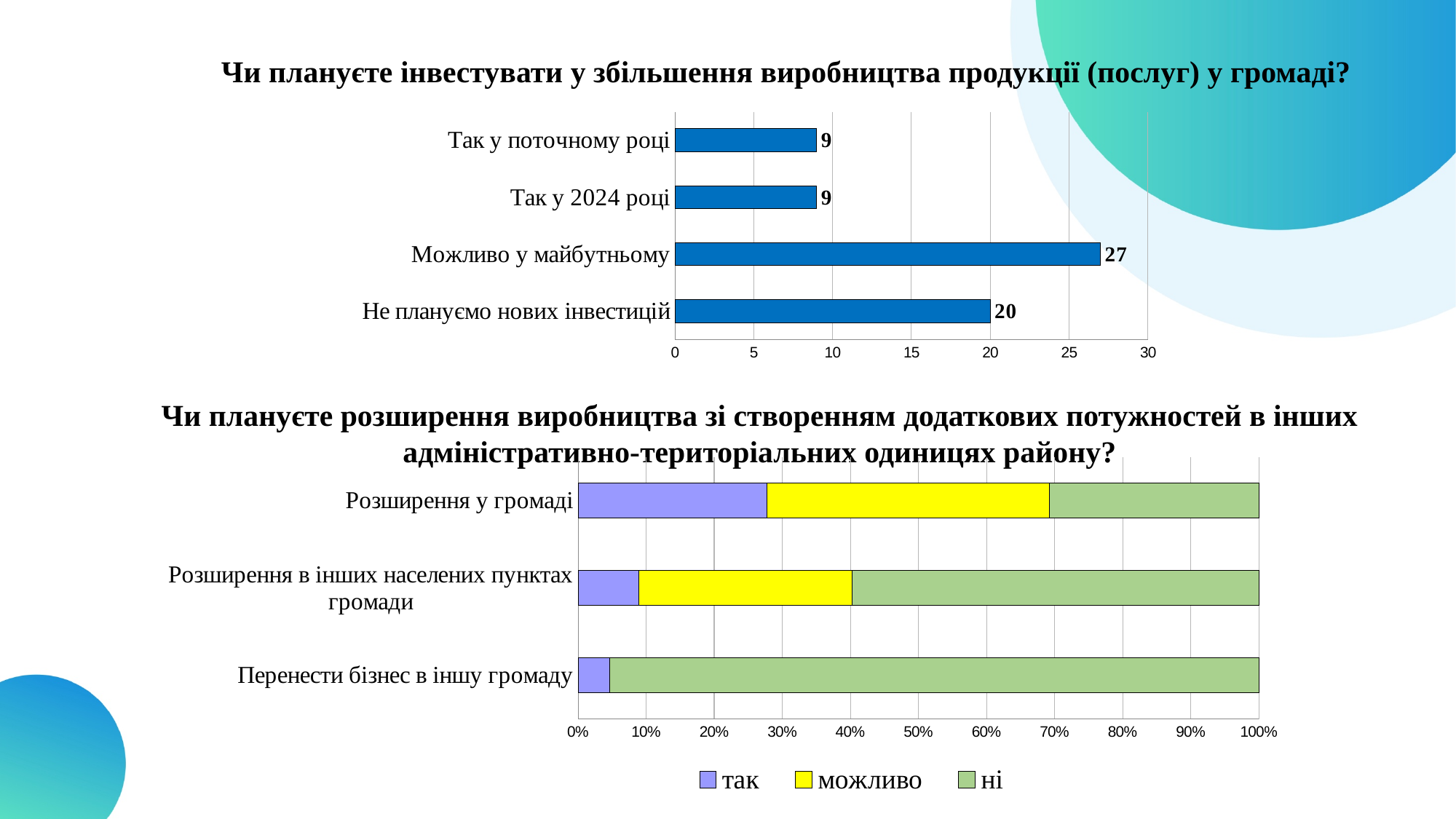
In the bottom chart, is the "так" share for "Розширення у громаді" greater or less than 20%? greater In the top chart, what is the difference between "Можливо у майбутньому" and "Не плануємо нових інвестицій"? 7 In the bottom chart, which colour represents the series "можливо"? Yellow In the top chart, which is larger: "Не плануємо нових інвестицій" or "Так у поточному році"? Не плануємо нових інвестицій What kind of chart is the top chart? Bar chart In the top chart ("Чи плануєте інвестувати у збільшення виробництва продукції (послуг) у громаді?"), what is the value for "Можливо у майбутньому"? 27 How many series does the legend of the bottom chart list? 3 In the bottom chart, is the "ні" share for "Перенести бізнес в іншу громаду" greater or less than 90%? greater How many categories does the top chart show? 4 In the top chart, which category has the highest value? Можливо у майбутньому In the top chart, what is the value for "Не плануємо нових інвестицій"? 20 In the top chart, what is the value for "Так у 2024 році"? 9